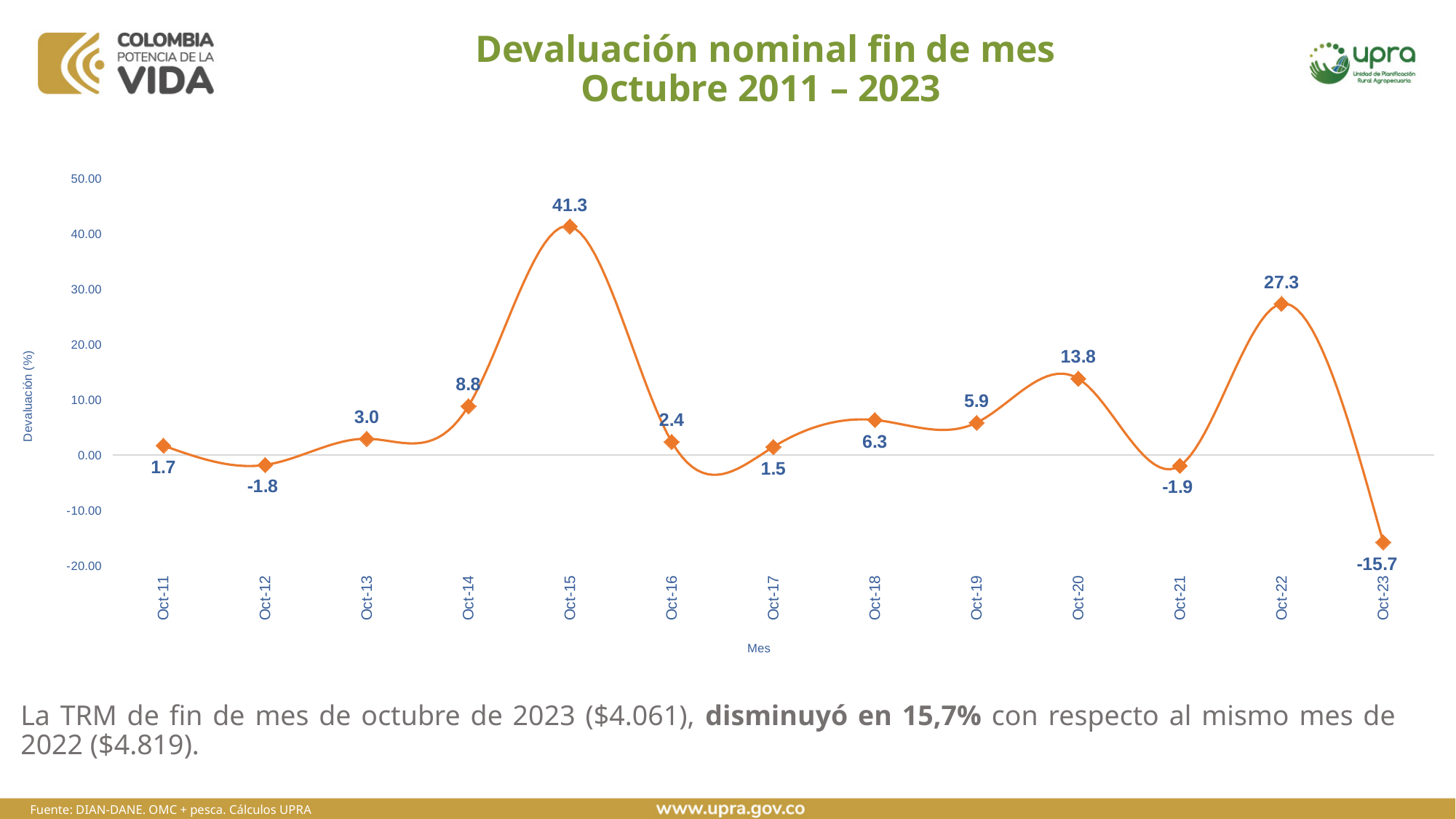
What is the devaluation value for Oct-15? 41.3 What is the devaluation value for Oct-23? -15.7 Do the values rise or fall from Oct-22 to Oct-23? Fall Which month has the highest devaluation value? Oct-15 Is the value for Oct-22 greater or less than 20.00? greater How many data points are plotted on the chart? 13 What is the devaluation value for Oct-20? 13.8 What is the label of the y axis? Devaluación (%) What kind of chart is shown on the slide? Line chart Which month has the lowest devaluation value? Oct-23 What is the difference between the values for Oct-15 and Oct-22? 14.0 Which is larger, the value for Oct-14 or the value for Oct-18? Oct-14